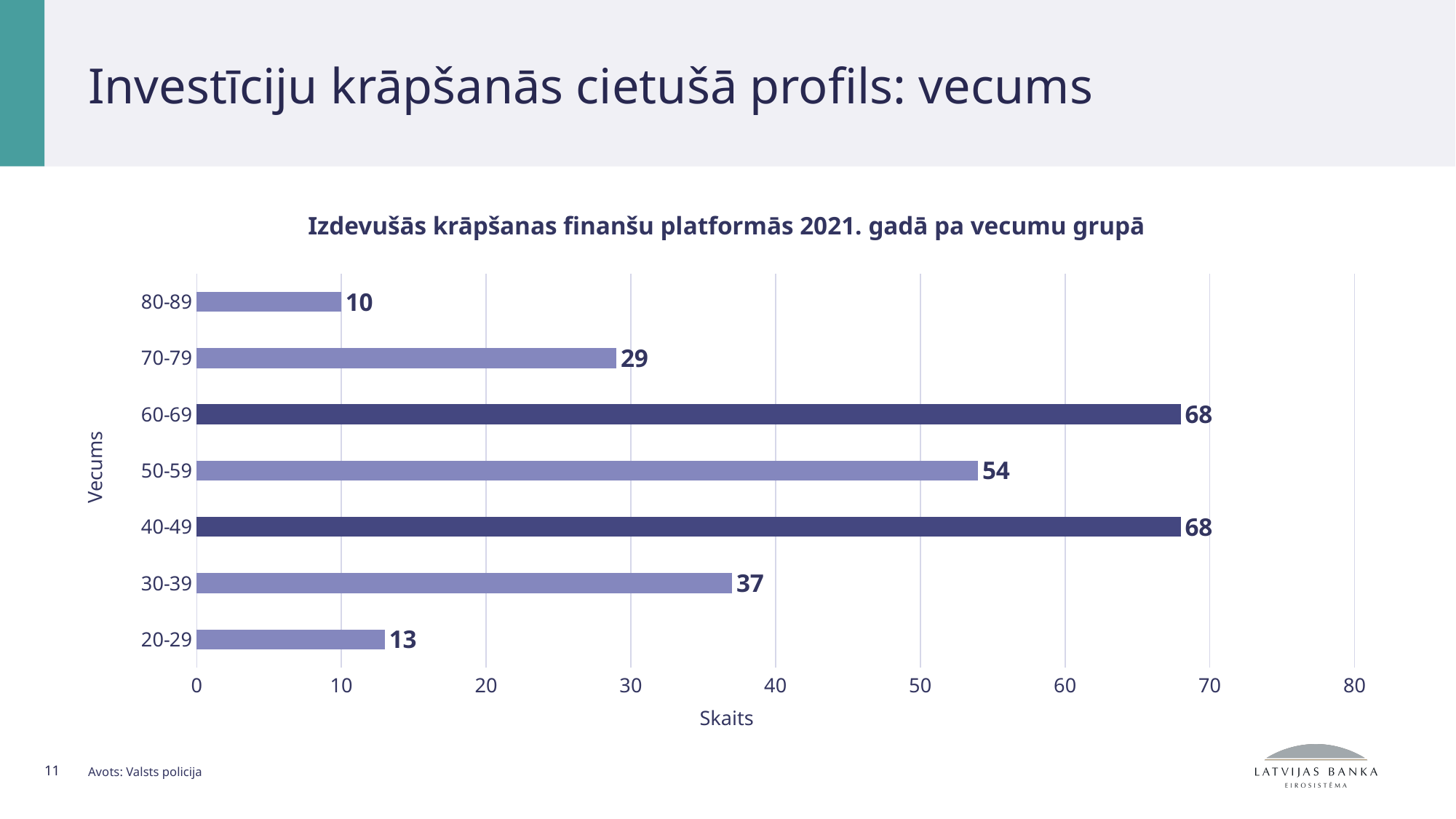
What is the difference between the values for 50-59 and 30-39? 17 What is the value for the 20-29 age group? 13 Which is larger, the value for 30-39 or the value for 70-79? 30-39 What is the difference between the values for 60-69 and 70-79? 39 How many age groups are shown in the chart? 7 What is the value for the 70-79 age group? 29 What is the value for the 50-59 age group? 54 What is the title of the chart? Izdevušās krāpšanas finanšu platformās 2021. gadā pa vecumu grupā Which two age groups share the highest value of 68? 40-49 and 60-69 Which age group has the lowest value? 80-89 Is the value for 50-59 greater or less than 50? greater What kind of chart is shown on the slide? Bar chart